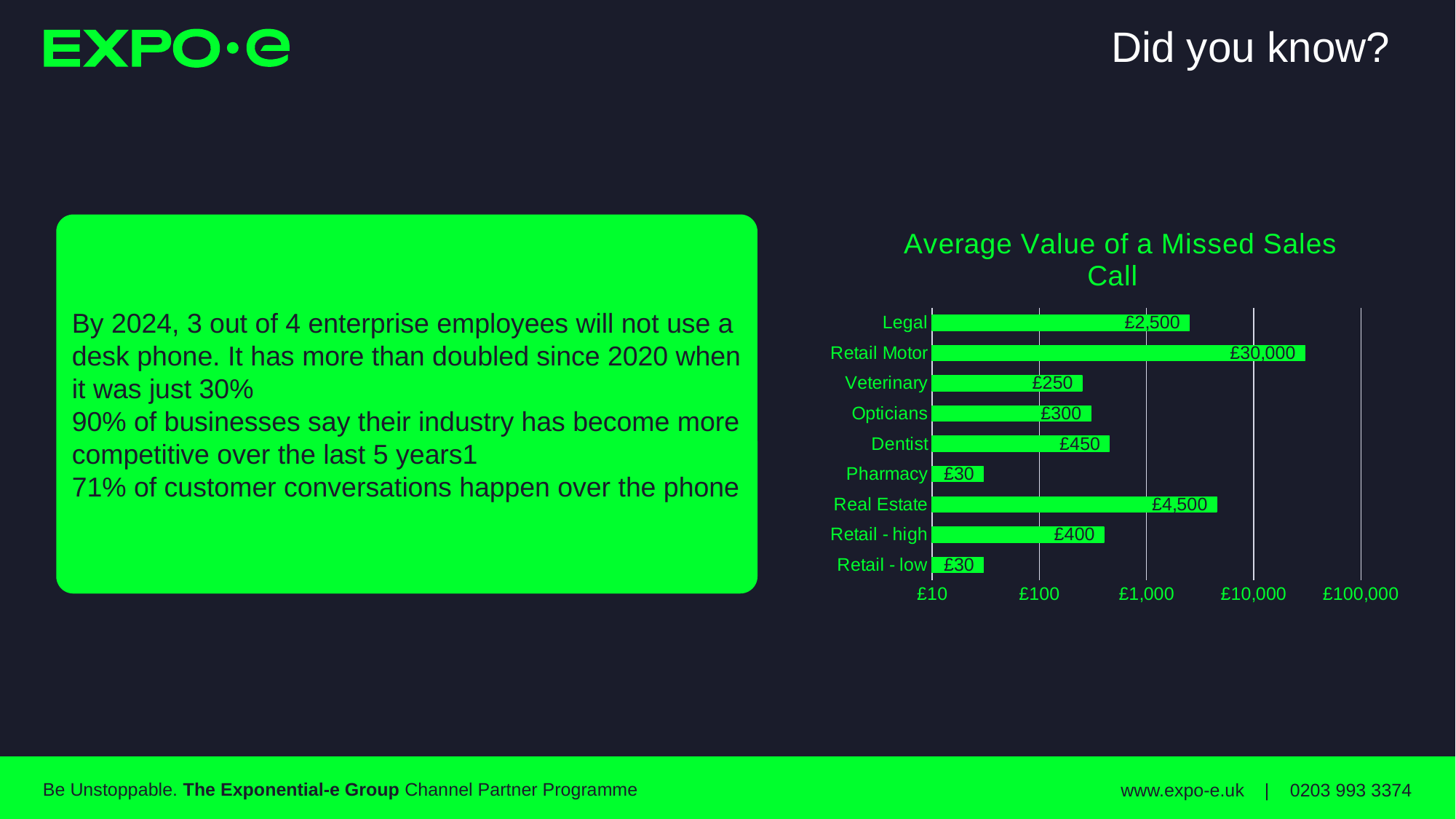
Which is larger, the value for Dentist or the value for Retail - high? Dentist What kind of chart is shown on the slide? Bar chart What is the average value of a missed sales call for Legal? £2,500 What is the difference between the values for Dentist and Opticians? £150 What is the average value of a missed sales call for Retail - high? £400 How many categories are shown in the chart? 9 Is the value for Retail Motor greater or less than £10,000? greater What is the average value of a missed sales call for Real Estate? £4,500 What is the title of the chart? Average Value of a Missed Sales Call What is the average value of a missed sales call for Dentist? £450 Which category has the highest average value of a missed sales call? Retail Motor What is the difference between the values for Real Estate and Legal? £2,000